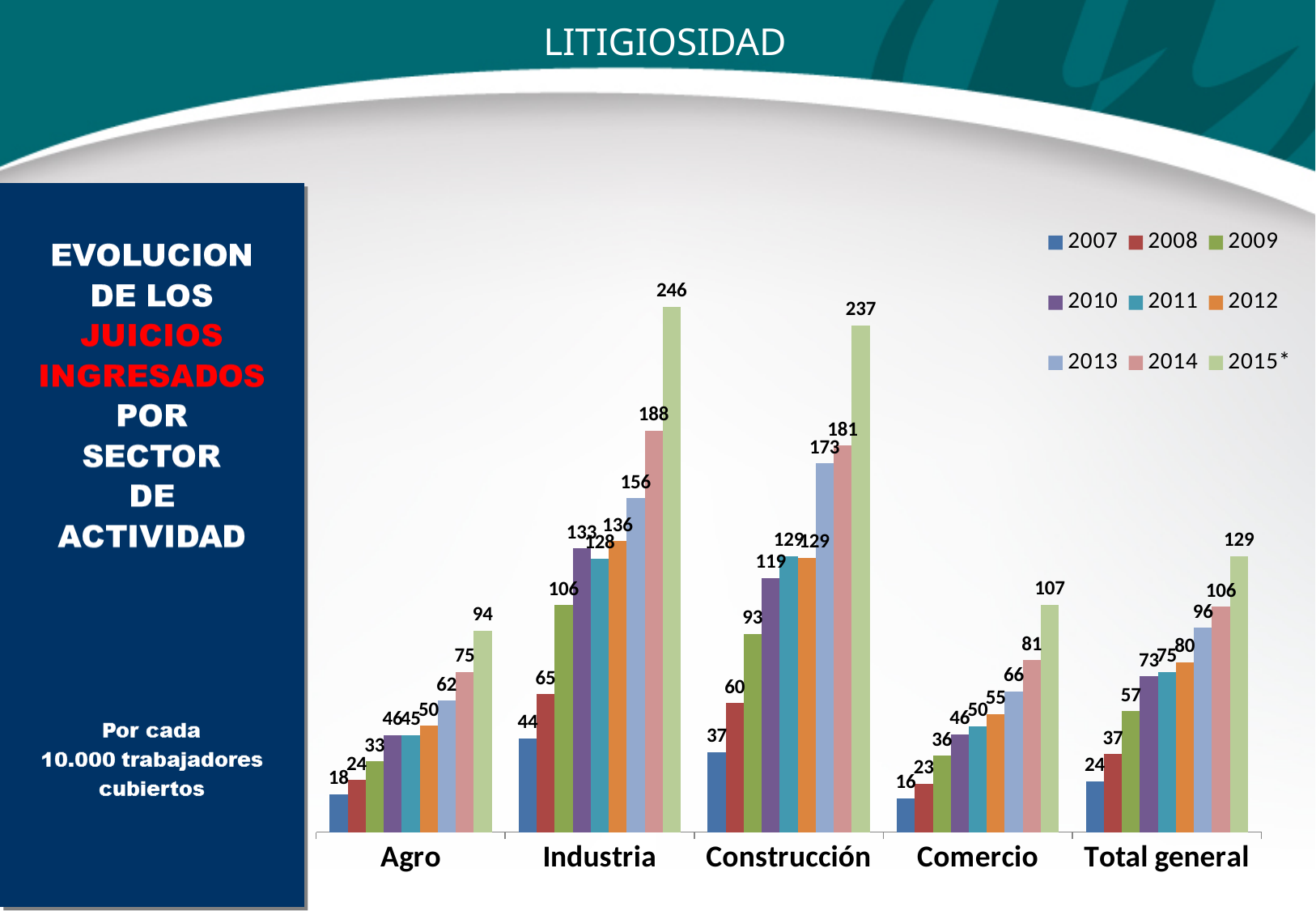
Which sector has the highest value in 2015*? Industria What is the value for Agro in 2007? 18 How many series does the legend list? 9 What is the value for Industria in 2015*? 246 How many sector categories are shown on the x axis? 5 What is the value for Comercio in 2014? 81 What kind of chart is shown on the slide? Bar chart What is the value for Total general in 2013? 96 Which sector has the lowest value in 2007? Comercio Which is larger, the 2014 value for Agro or the 2014 value for Comercio? Comercio What is the difference between the 2015* values for Industria and Construcción? 9 Do the values for Total general rise or fall from 2007 to 2015*? Rise